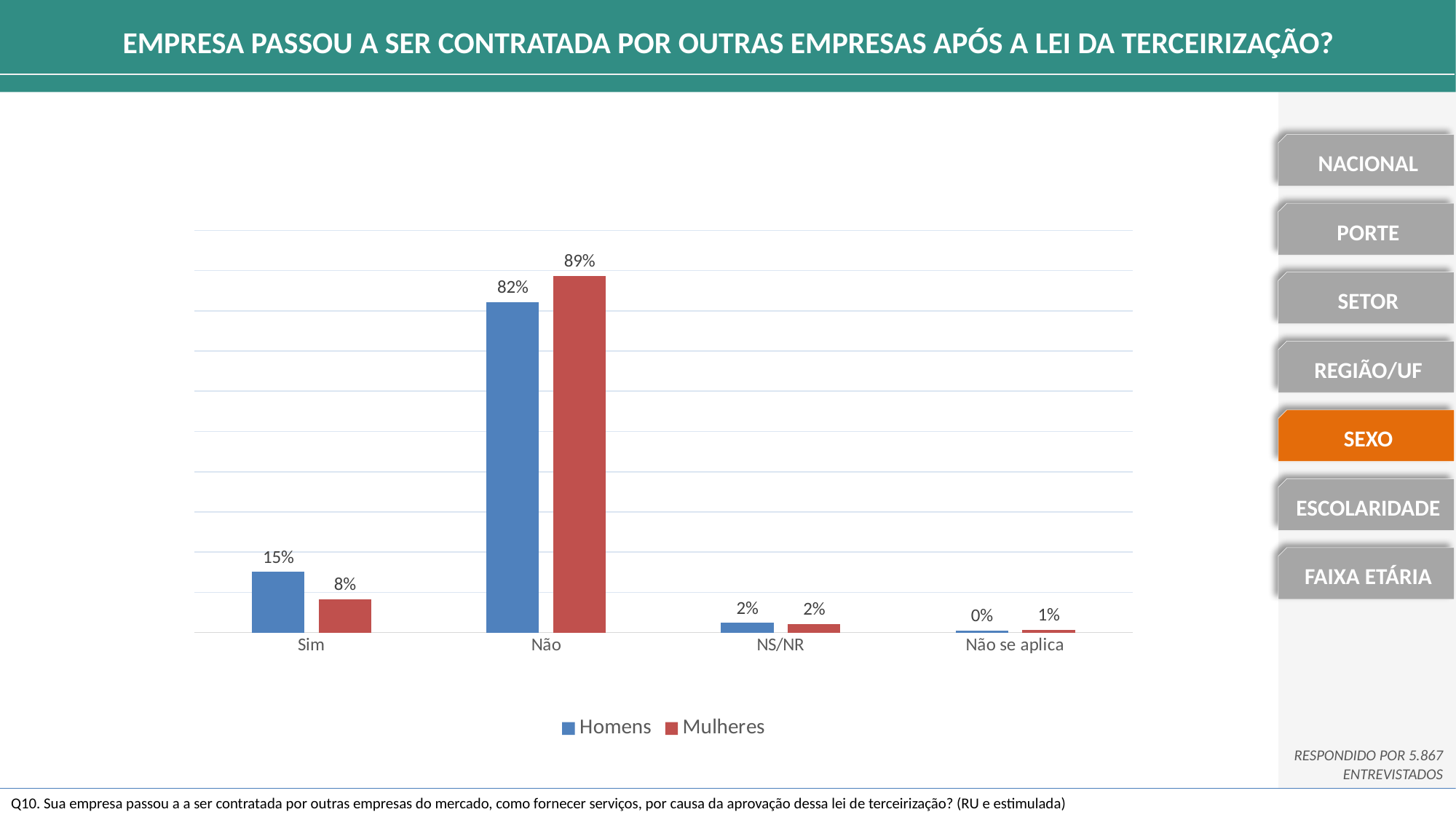
Which colour represents the Mulheres series? Red What is the difference between Homens and Mulheres in the Sim category? 7% How many categories are shown on the x axis? 4 Which category has the highest value for Homens? Não What is the value for Mulheres in the Não category? 89% What kind of chart is shown on the slide? Bar chart What is the value for Homens in the Sim category? 15% Which category has the lowest value for Mulheres? Não se aplica How many series does the legend list? 2 Which is larger in the Sim category, Homens or Mulheres? Homens What is the difference between Mulheres and Homens in the Não category? 7% What is the value for Mulheres in the Não se aplica category? 1%